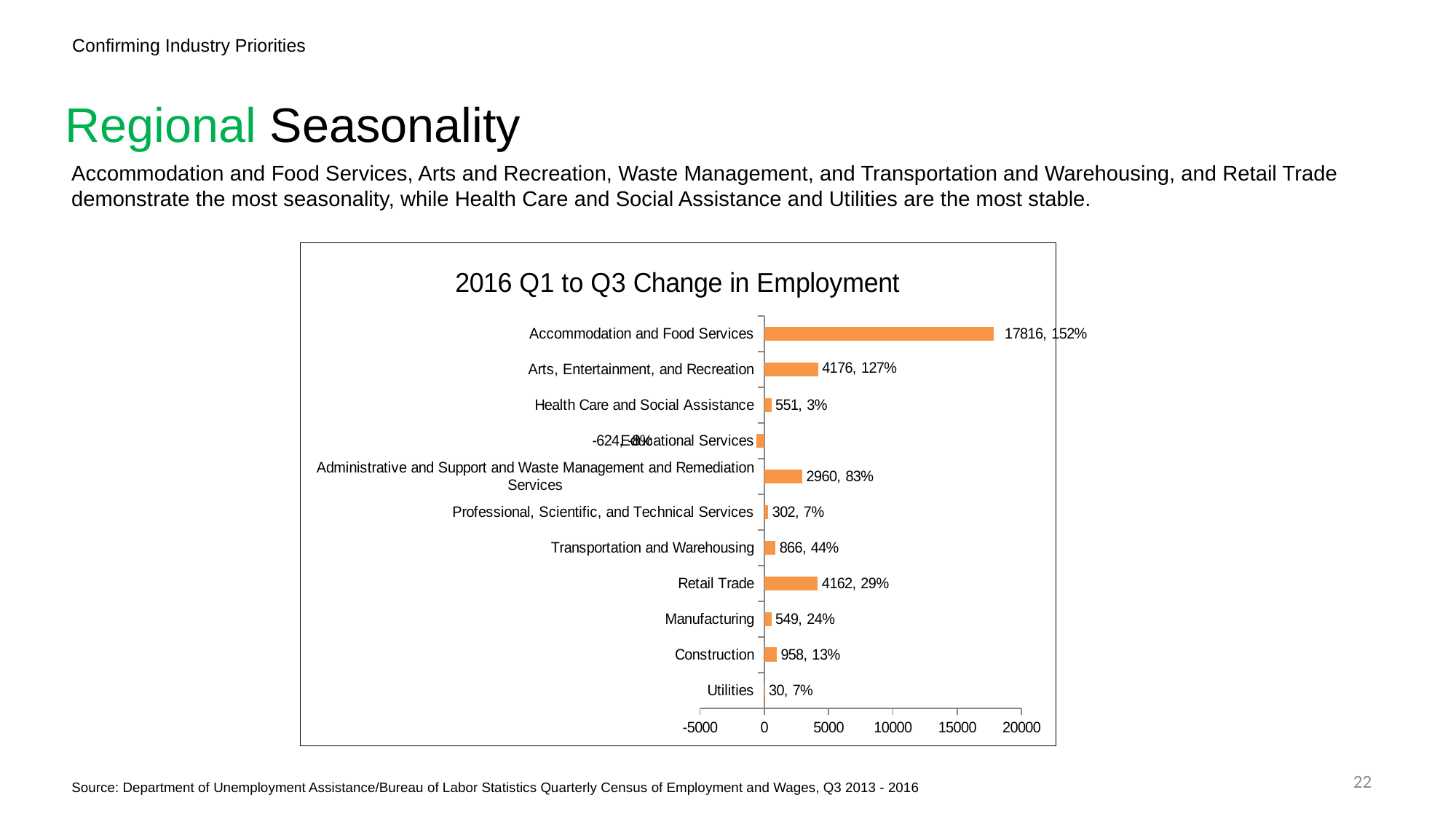
What is the data label shown for Administrative and Support and Waste Management and Remediation Services? 2960, 83% What kind of chart is shown on the slide? bar chart What is the data label shown for Retail Trade? 4162, 29% What is the title of the chart? 2016 Q1 to Q3 Change in Employment What is the difference in employment change between Arts, Entertainment, and Recreation (4176) and Retail Trade (4162)? 14 What is the data label shown for Accommodation and Food Services? 17816, 152% Is the value for Accommodation and Food Services greater or less than 15000? greater Which industry has the largest change in employment? Accommodation and Food Services What is the data label shown for Utilities? 30, 7% Which industry is the only one with a negative change in employment? Educational Services How many industry categories are plotted in the chart? 11 Which has a larger change in employment, Construction or Manufacturing? Construction